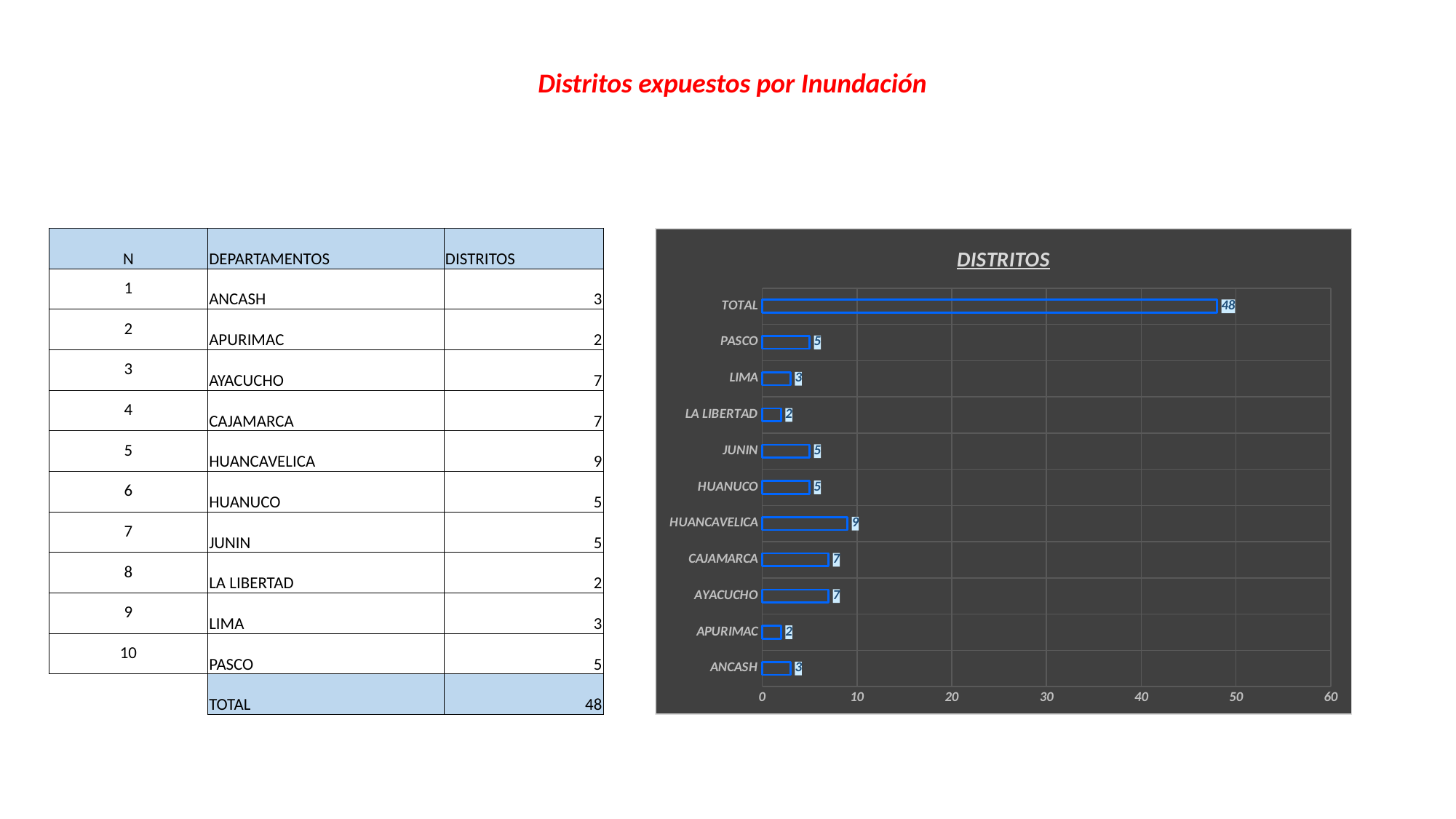
What is the value for PASCO in the DISTRITOS chart? 5 How many bars are plotted in the DISTRITOS chart? 11 What is the title of the chart on the slide? DISTRITOS What is the difference between the values for CAJAMARCA and APURIMAC in the DISTRITOS chart? 5 What is the difference between the values for HUANCAVELICA and LA LIBERTAD in the DISTRITOS chart? 7 What kind of chart is the DISTRITOS chart? bar chart What is the highest tick value shown on the horizontal axis of the DISTRITOS chart? 60 Excluding the TOTAL bar, which department has the highest value in the DISTRITOS chart? HUANCAVELICA In the DISTRITOS chart, which is larger, the value for AYACUCHO or the value for LIMA? AYACUCHO Is the value of the TOTAL bar in the DISTRITOS chart greater or less than 40? greater What is the value of the TOTAL bar in the DISTRITOS chart? 48 What is the value for HUANCAVELICA in the DISTRITOS chart? 9